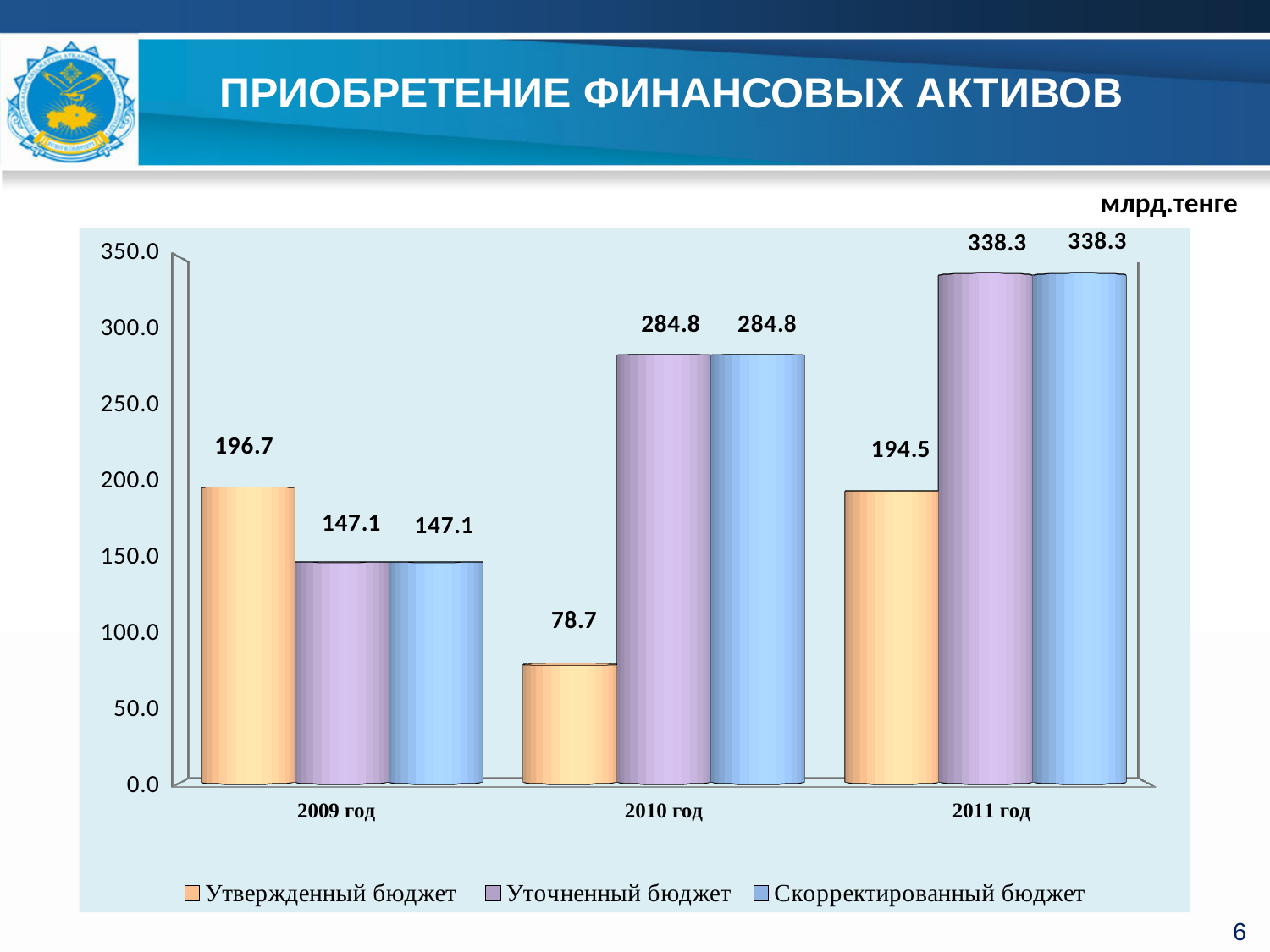
What is the difference between Уточненный бюджет and Утвержденный бюджет for 2010 год? 206.1 What is the value of Уточненный бюджет for 2010 год? 284.8 What is the value of Утвержденный бюджет for 2009 год? 196.7 What kind of chart is shown on the slide? Bar chart How many series does the legend list? 3 What is the value of Утвержденный бюджет for 2010 год? 78.7 How many year categories are shown on the x axis? 3 What is the value of Скорректированный бюджет for 2011 год? 338.3 Which year has the lowest value for Уточненный бюджет? 2009 год Which is larger for 2009 год: Утвержденный бюджет or Уточненный бюджет? Утвержденный бюджет Which year has the highest value for Утвержденный бюджет? 2009 год Do the values for Скорректированный бюджет rise or fall from 2009 год to 2011 год? Rise